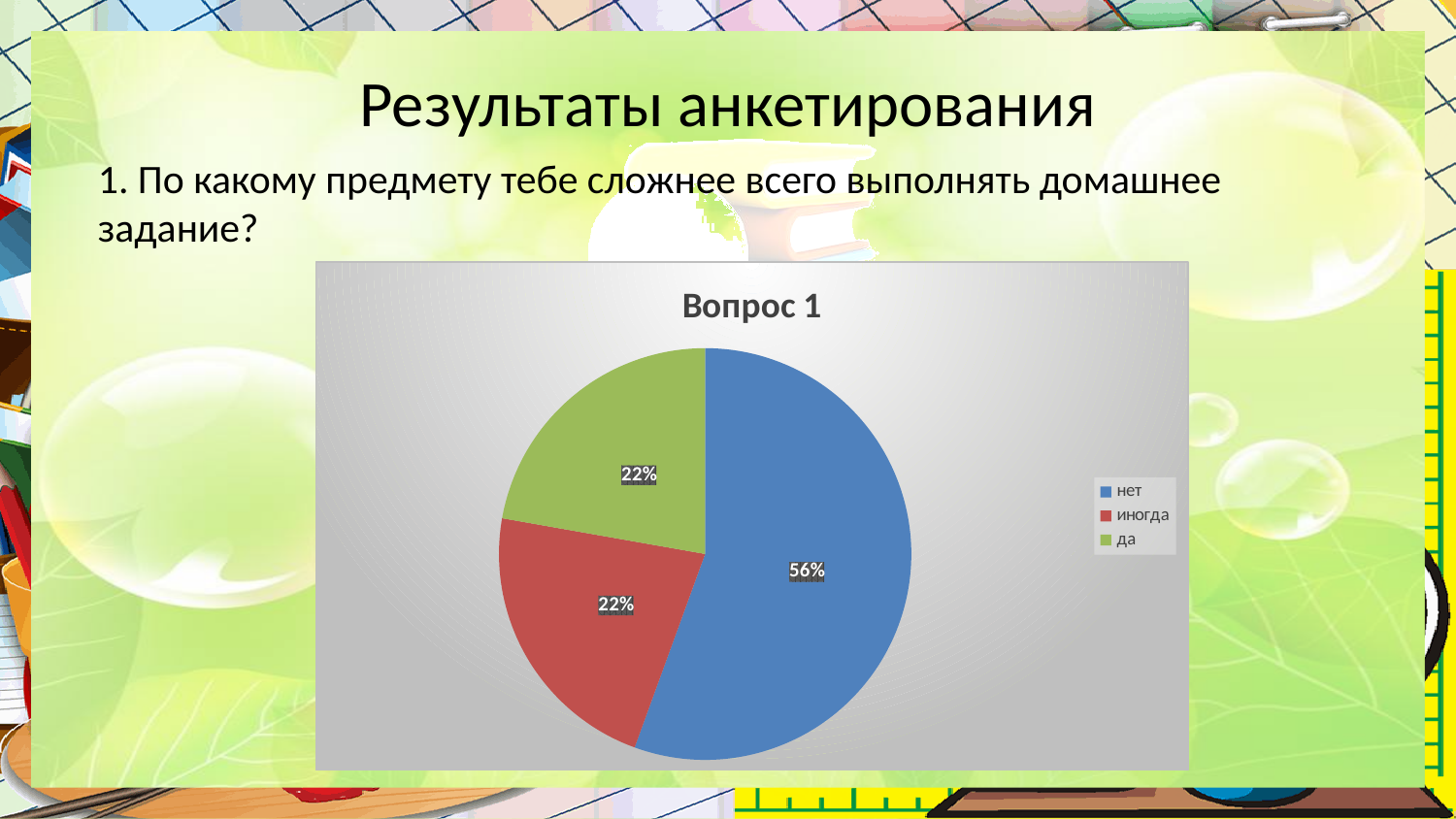
What percentage of the pie chart is the "да" slice? 22% What is the title of the chart? Вопрос 1 What colour is the "иногда" slice in the pie chart? red What percentage of the pie chart is the "иногда" slice? 22% Which slice is larger, "нет" or "да"? нет How many slices does the pie chart have? 3 Do the "иногда" and "да" slices have the same percentage? yes Which category has the largest slice of the pie chart? нет How many entries does the legend of the chart list? 3 What kind of chart is shown on the slide? pie chart What is the difference in percentage points between the "нет" slice and the "иногда" slice? 34 What percentage of the pie chart is the "нет" slice? 56%